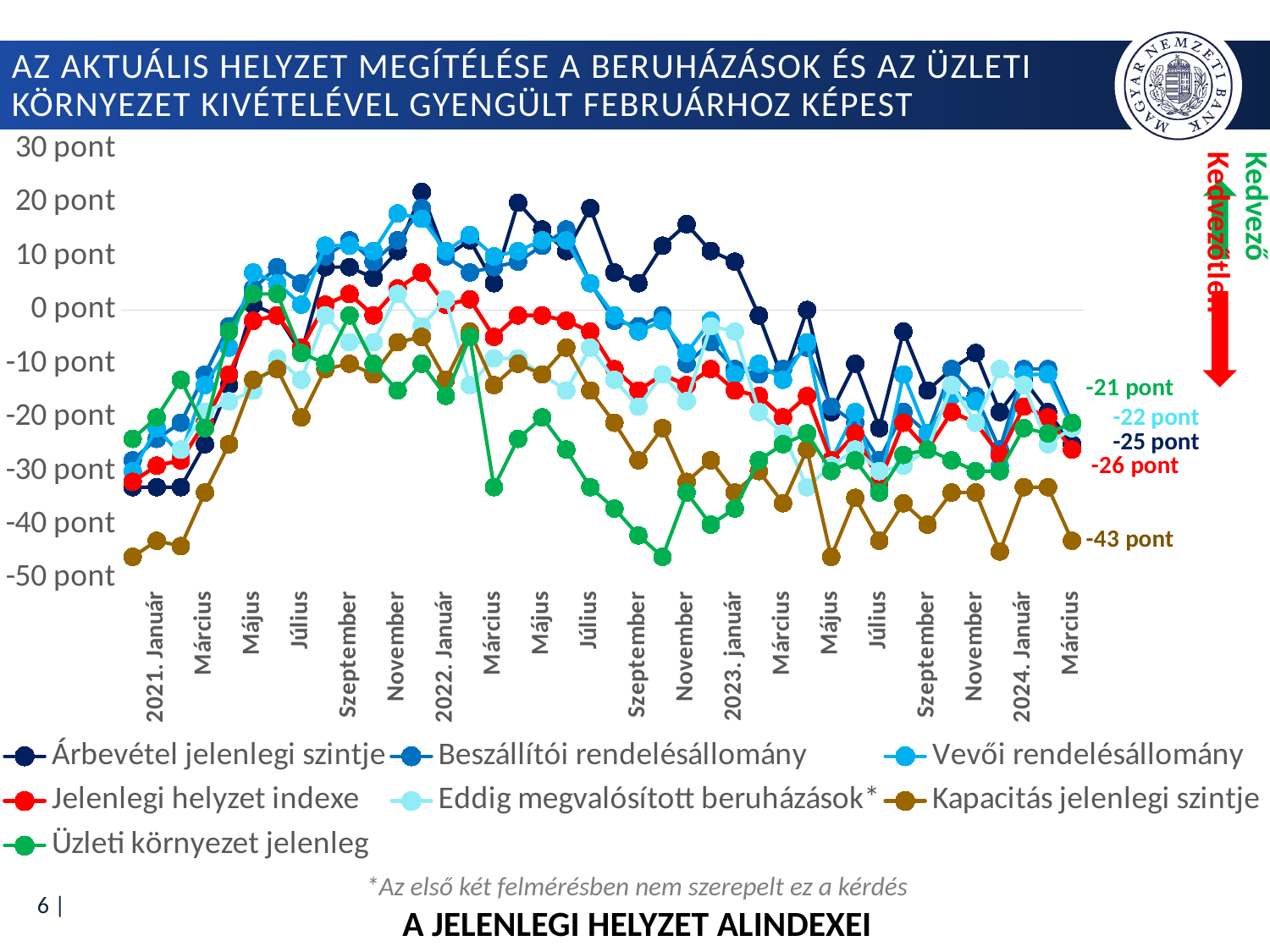
At the last point, which is higher: Jelenlegi helyzet indexe or Kapacitás jelenlegi szintje? Jelenlegi helyzet indexe What is the value labelled at the end of the series Üzleti környezet jelenleg? -21 pont What is the value labelled at the end of the series Jelenlegi helyzet indexe? -26 pont What is the difference between the final labelled values of Üzleti környezet jelenleg (-21 pont) and Kapacitás jelenlegi szintje (-43 pont)? 22 pont Which series is drawn in brown? Kapacitás jelenlegi szintje Is the value for Kapacitás jelenlegi szintje in 2021. Január greater or less than -40 pont? less What is the value labelled at the end of the series Árbevétel jelenlegi szintje? -25 pont What is the value labelled at the end of the series Kapacitás jelenlegi szintje? -43 pont Which series has the lowest value at the last point (Március 2024)? Kapacitás jelenlegi szintje How many series does the legend list? 7 What is the value labelled at the end of the series Eddig megvalósított beruházások? -22 pont What type of chart is shown on the slide? line chart